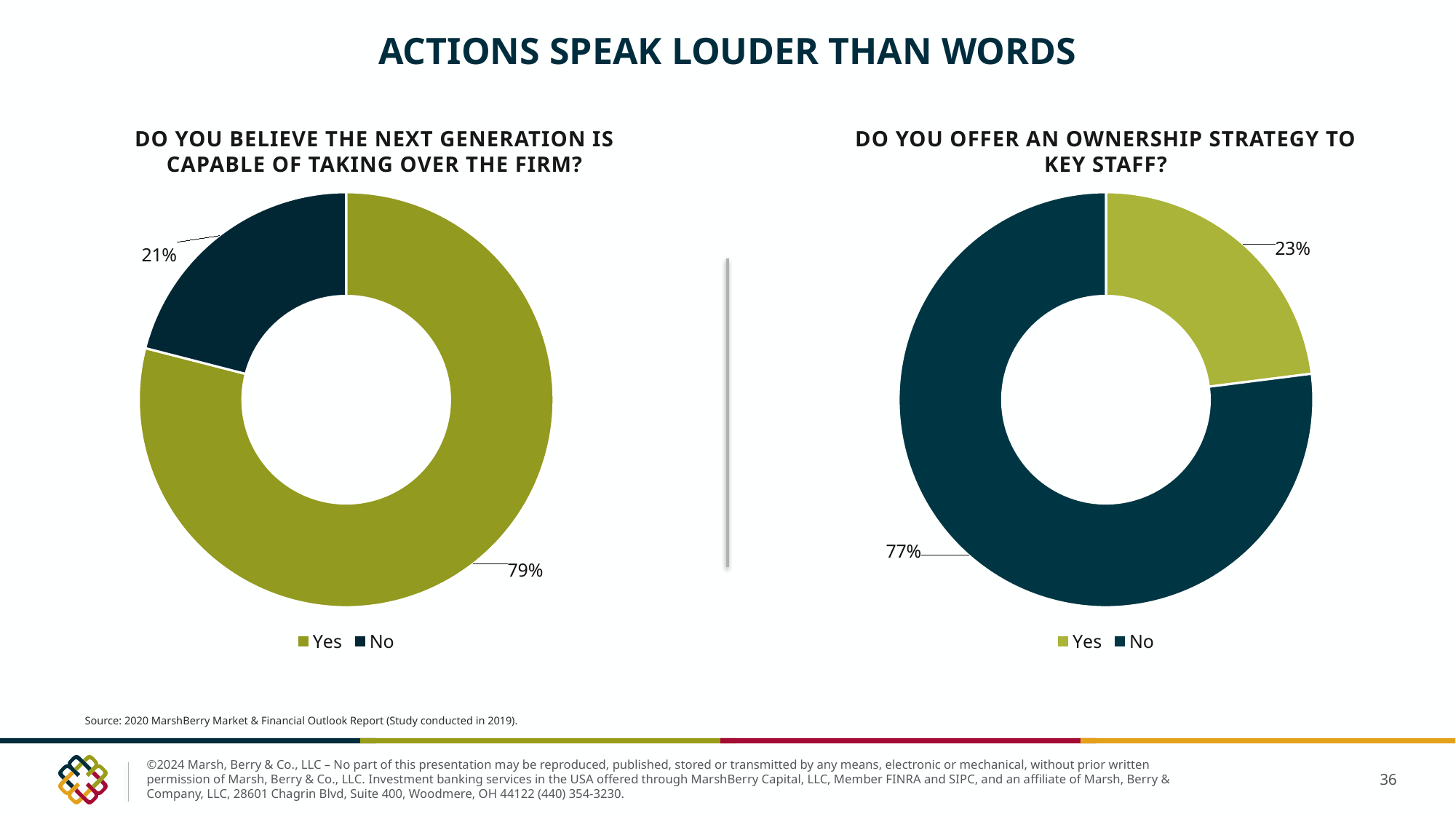
What colour represents the No response in both charts? Dark blue In the chart titled "Do you believe the next generation is capable of taking over the firm?", what percentage answered Yes? 79% In the chart titled "Do you offer an ownership strategy to key staff?", what percentage answered No? 77% Is the Yes share larger in the left chart or the right chart? Left chart In the chart titled "Do you believe the next generation is capable of taking over the firm?", what percentage answered No? 21% In the chart titled "Do you offer an ownership strategy to key staff?", what percentage answered Yes? 23% In the left chart, what is the difference between the Yes and No shares? 58% In the right chart, what is the difference between the No and Yes shares? 54% What type of chart is used on the left side of the slide? Doughnut (pie) chart In the left chart, which response has the largest share? Yes How many series does the legend of the right chart list? 2 In the right chart, which response has the smallest share? Yes